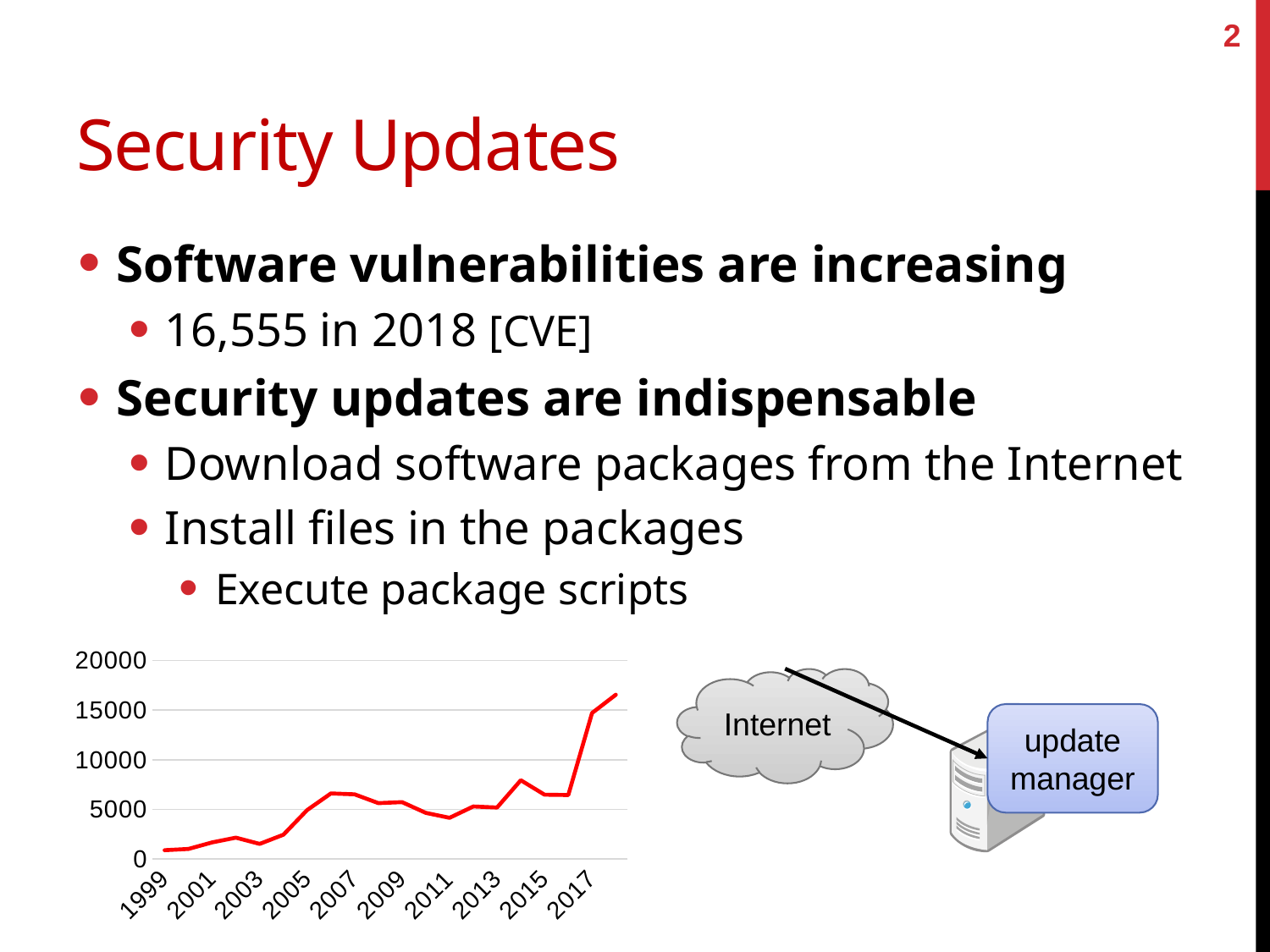
What is the highest value shown on the y axis of the line chart? 20000 In the line chart, is the value for 2017 greater or less than 10000? greater What kind of chart is shown at the bottom left of the slide? line chart In the line chart, which is larger, the value for 2007 or the value for 2011? 2007 In the line chart, do the values generally rise or fall from 1999 to the end of the series? rise In the line chart, which is larger, the value for 2017 or the value for 2009? 2017 In the line chart, is the value for 2015 greater or less than 10000? less In the line chart, which labeled year has the lowest value? 1999 In the line chart, is the value for 1999 greater or less than 5000? less How many year labels are shown on the x axis of the line chart? 10